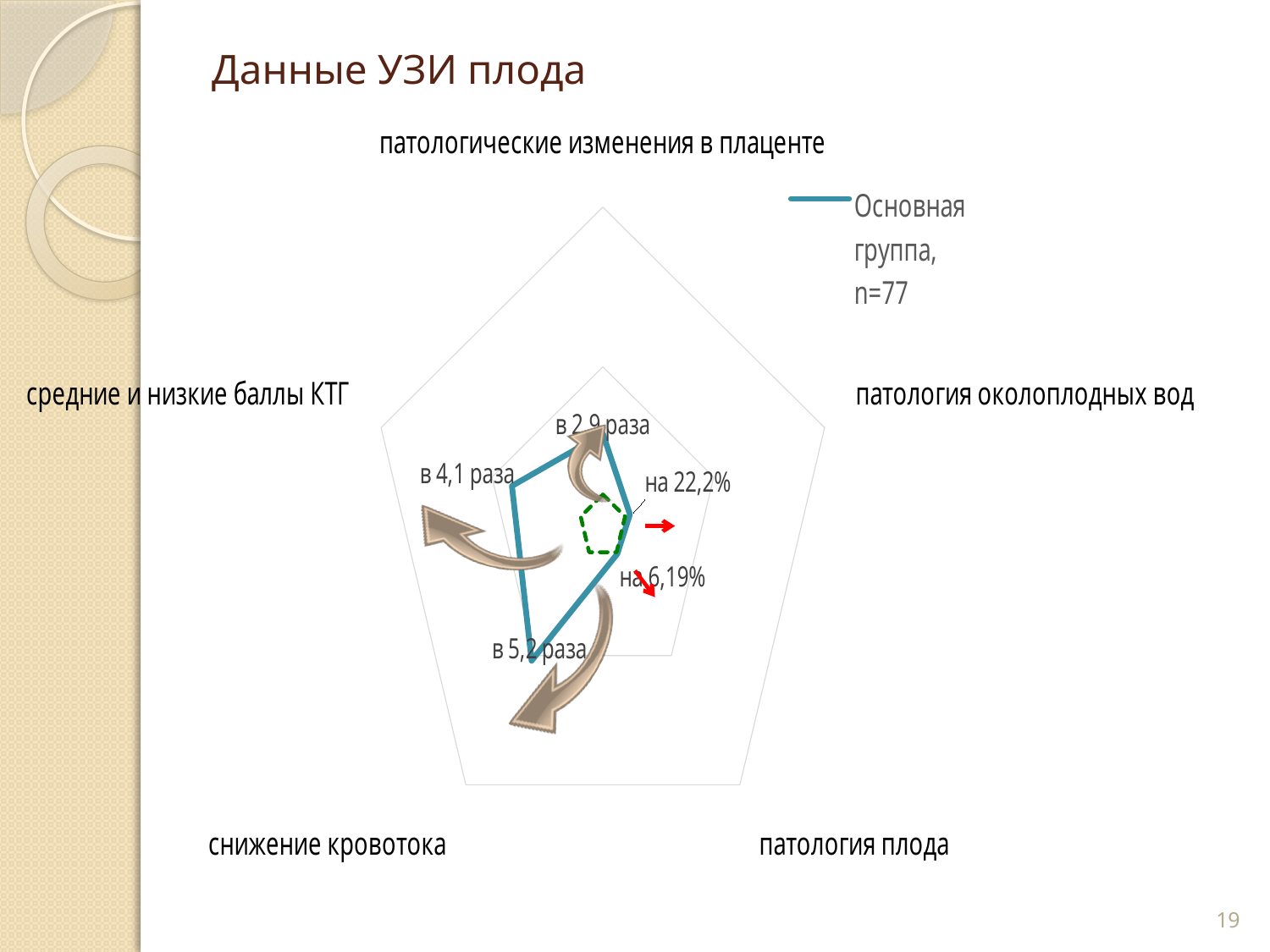
What is the legend entry of the radar chart? Основная группа, n=77 What kind of chart is shown on the slide? radar chart Which is larger for the Основная группа series: the value for патологические изменения в плаценте or for патология околоплодных вод? патологические изменения в плаценте How many series does the legend of the radar chart list? 1 Which is larger for the Основная группа series: the value for снижение кровотока or for патология околоплодных вод? снижение кровотока How many axes (categories) does the radar chart have? 5 Which is larger for the Основная группа series: the value for средние и низкие баллы КТГ or for патология плода? средние и низкие баллы КТГ What is the title of the slide containing the radar chart? Данные УЗИ плода On which axis does the Основная группа series reach its highest value? снижение кровотока